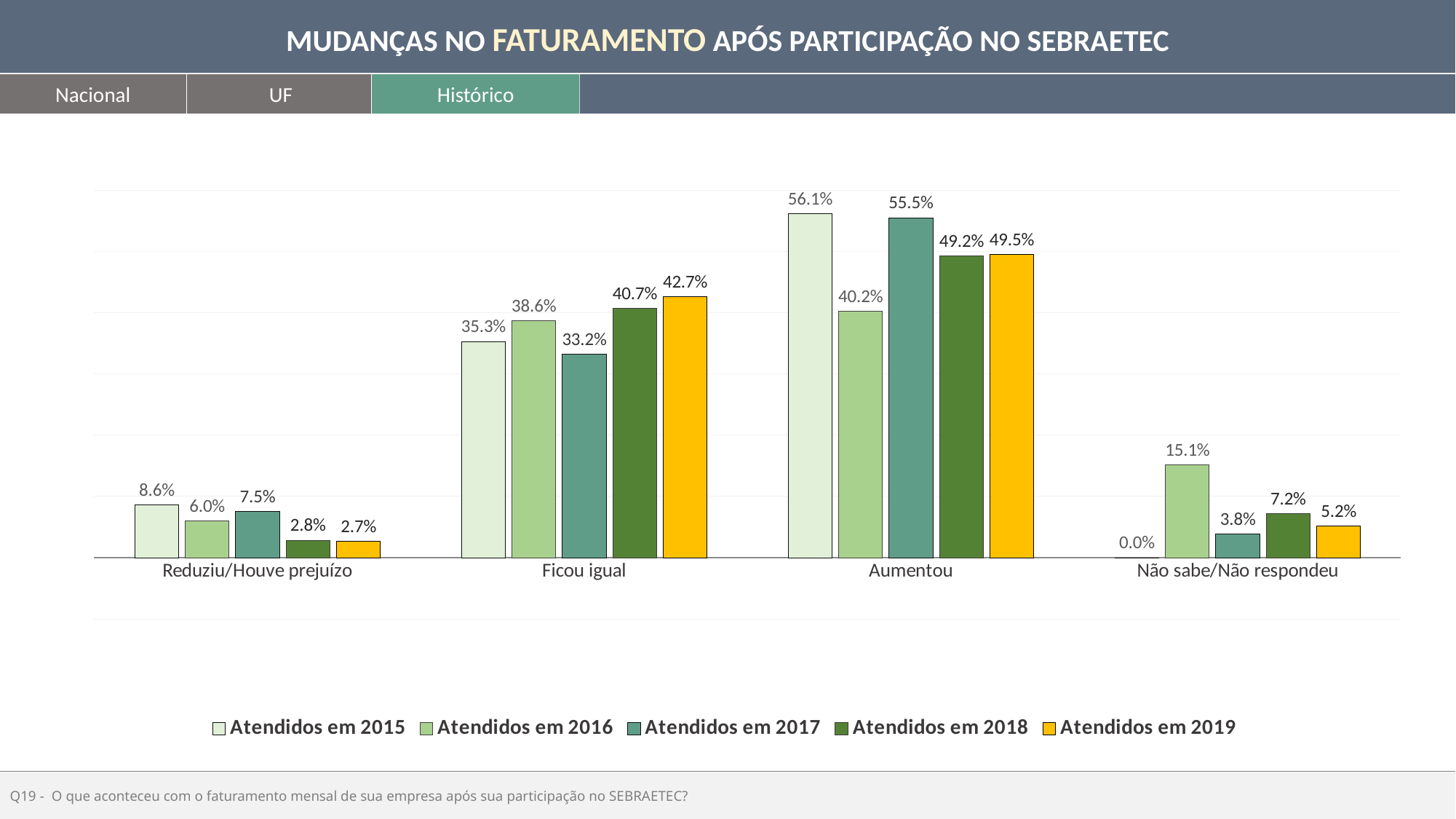
What kind of chart is shown on the slide? Bar chart What is the difference between the Atendidos em 2015 and Atendidos em 2016 values for 'Aumentou'? 15.9% What is the value for 'Reduziu/Houve prejuízo' for Atendidos em 2018? 2.8% How many categories are shown on the x axis? 4 Which category has the highest value for Atendidos em 2017? Aumentou Which legend entry is shown in yellow? Atendidos em 2019 How many series does the legend list? 5 What is the value for 'Aumentou' for Atendidos em 2015? 56.1% What is the value for 'Não sabe/Não respondeu' for Atendidos em 2016? 15.1% Which category has the lowest value for Atendidos em 2015? Não sabe/Não respondeu What is the value for 'Ficou igual' for Atendidos em 2019? 42.7% Which is larger for 'Ficou igual': the value for Atendidos em 2016 or Atendidos em 2017? Atendidos em 2016